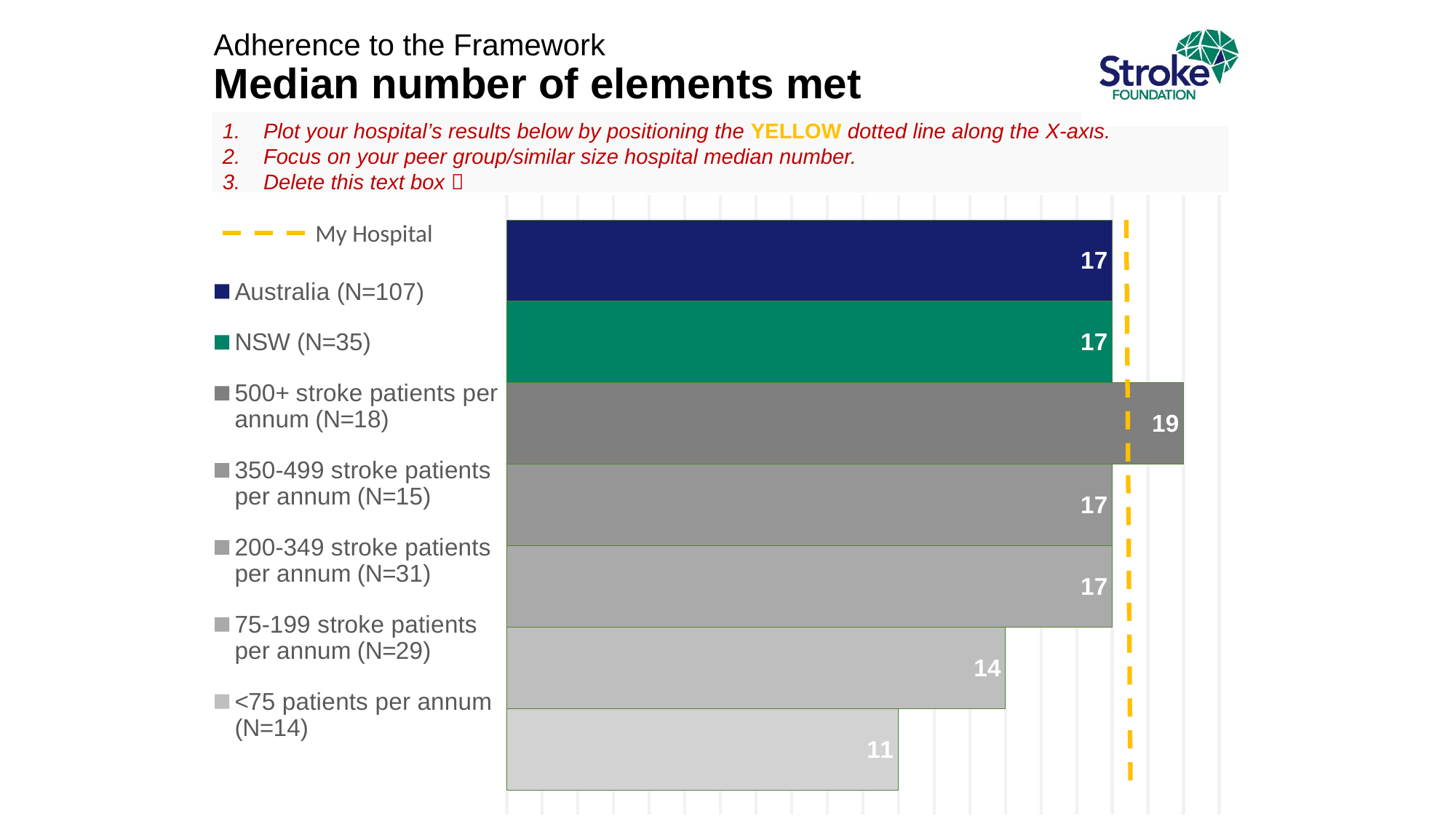
What is the median number of elements met for NSW (N=35)? 17 What is the median number of elements met for Australia (N=107)? 17 What is the median number of elements met for hospitals with <75 patients per annum (N=14)? 11 What is the median number of elements met for hospitals with 75-199 stroke patients per annum (N=29)? 14 How many bars are plotted in the chart? 7 Which has a larger median number of elements met: 75-199 stroke patients per annum or 200-349 stroke patients per annum? 200-349 stroke patients per annum What is the median number of elements met for hospitals with 500+ stroke patients per annum (N=18)? 19 Which group has the highest median number of elements met? 500+ stroke patients per annum (N=18) Which group has the lowest median number of elements met? <75 patients per annum (N=14) What is the difference between the median for 500+ stroke patients per annum and the median for <75 patients per annum? 8 What does the yellow dashed line in the legend represent? My Hospital What type of chart is shown on the slide? Bar chart